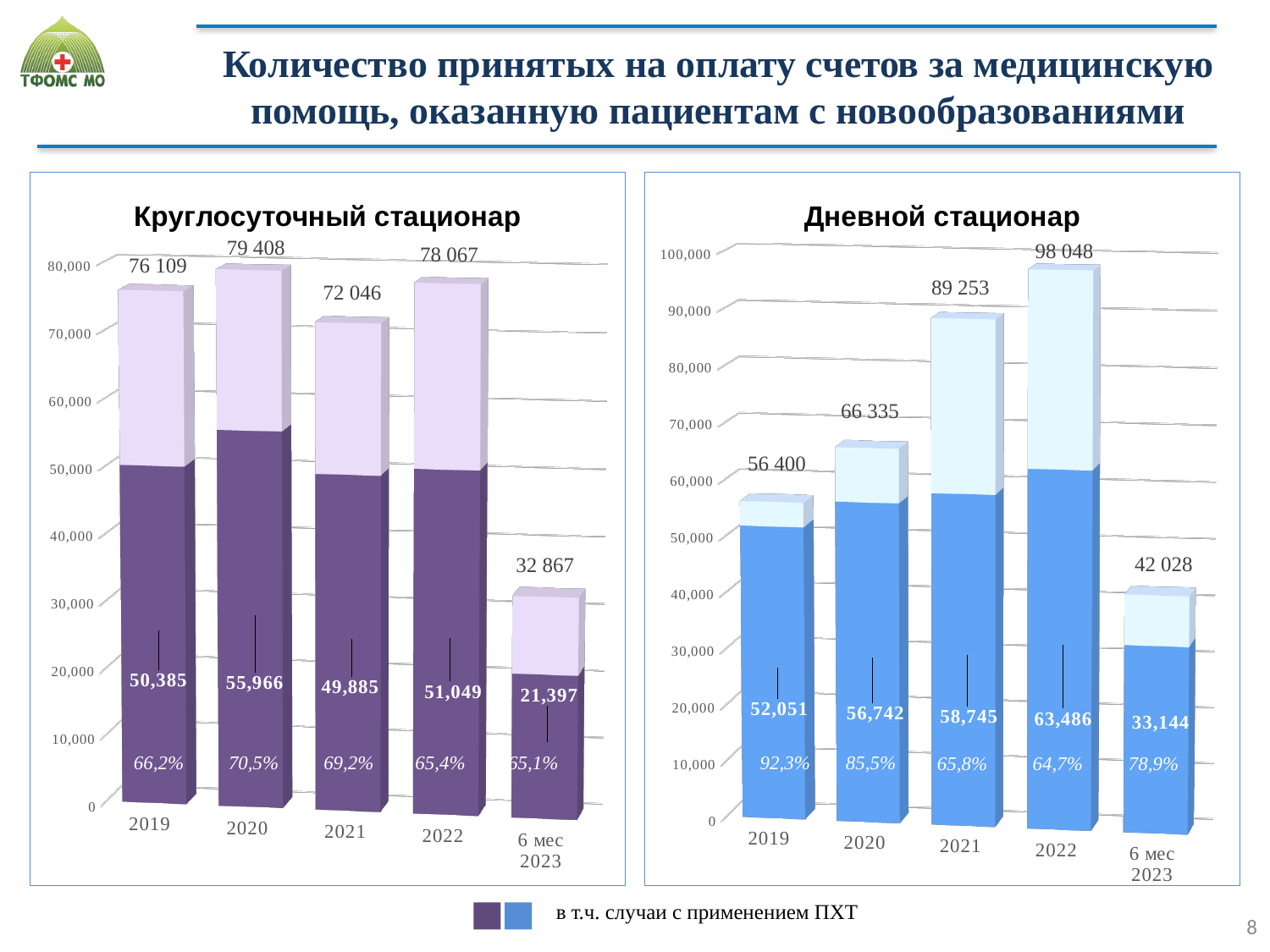
In the 'Круглосуточный стационар' chart, what is the difference between the totals for 2020 and 2019? 3 299 In the 'Дневной стационар' chart, what is the difference between the totals for 2022 and 2021? 8 795 In the 'Круглосуточный стационар' chart, what percentage is shown for 2022? 65,4% In the 'Круглосуточный стационар' chart, what is the value of the ПХТ portion for 2021? 49,885 In the 'Дневной стационар' chart, is the ПХТ value for 2022 larger than the ПХТ value for 2021? Yes In the 'Дневной стационар' chart, which year has the highest percentage shown? 2019 In the 'Дневной стационар' chart, what is the total for 2021? 89 253 In the 'Круглосуточный стационар' chart, which year has the highest total? 2020 In the 'Дневной стационар' chart, what is the ПХТ value for 6 мес 2023? 33,144 How many categories (periods) are shown on the x axis of the 'Круглосуточный стационар' chart? 5 In the 'Круглосуточный стационар' chart, what is the total number of accounts for 2020? 79 408 What type of chart is the 'Дневной стационар' chart? Stacked bar chart